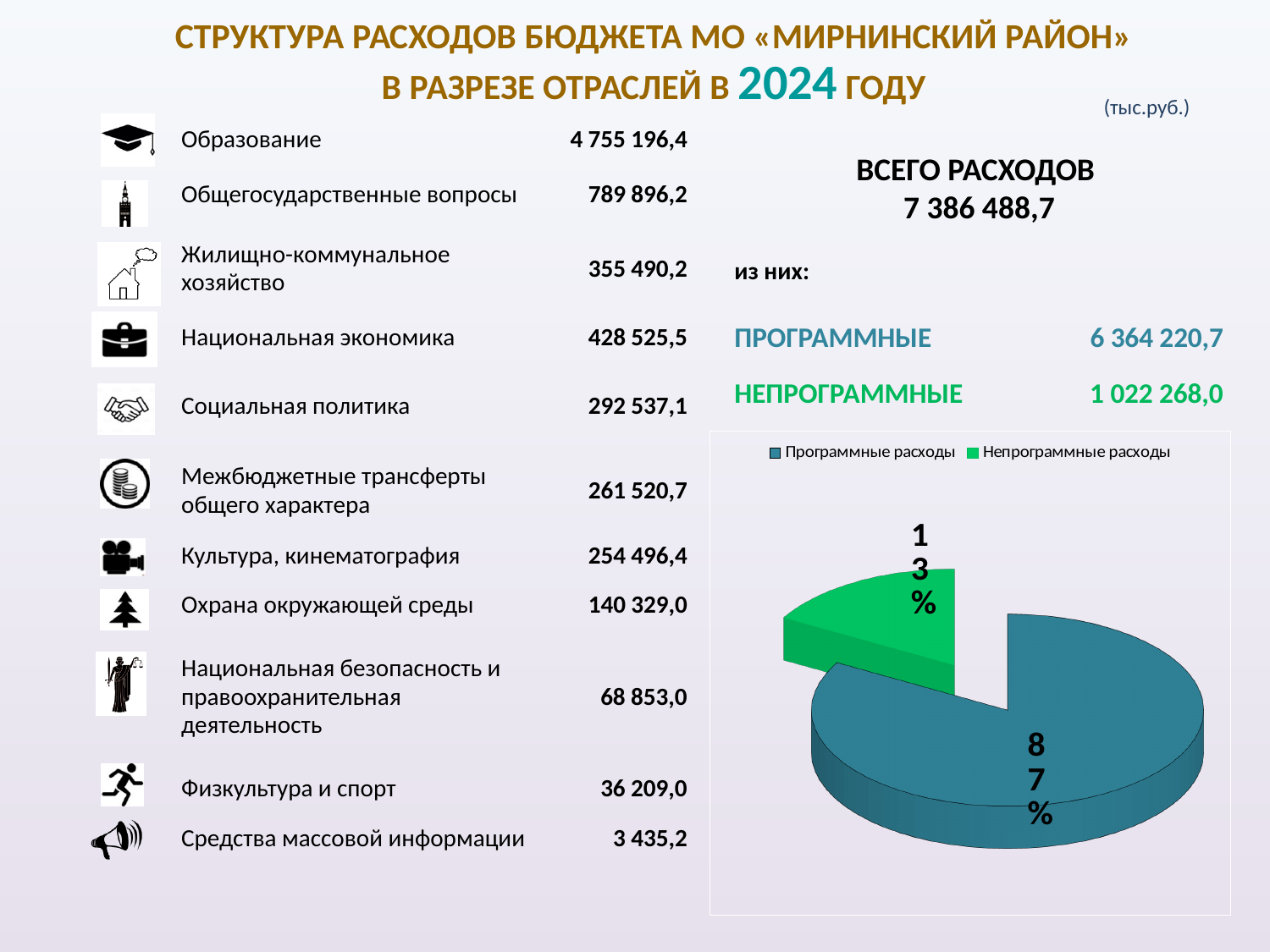
Which is larger in the pie chart, Программные расходы or Непрограммные расходы? Программные расходы What share of the pie chart is labelled for Программные расходы? 87% What share of the pie chart is labelled for Непрограммные расходы? 13% What kind of chart is shown on the slide? pie chart Which slice of the pie chart is the smallest? Непрограммные расходы What colour is the Непрограммные расходы slice in the pie chart? green Is the share for Непрограммные расходы greater or less than 50%? less What is the difference in percentage points between the Программные расходы slice and the Непрограммные расходы slice? 74 percentage points How many slices does the pie chart have? 2 Which slice of the pie chart is the largest? Программные расходы How many entries does the pie chart's legend list? 2 What colour is the Программные расходы slice in the pie chart? blue